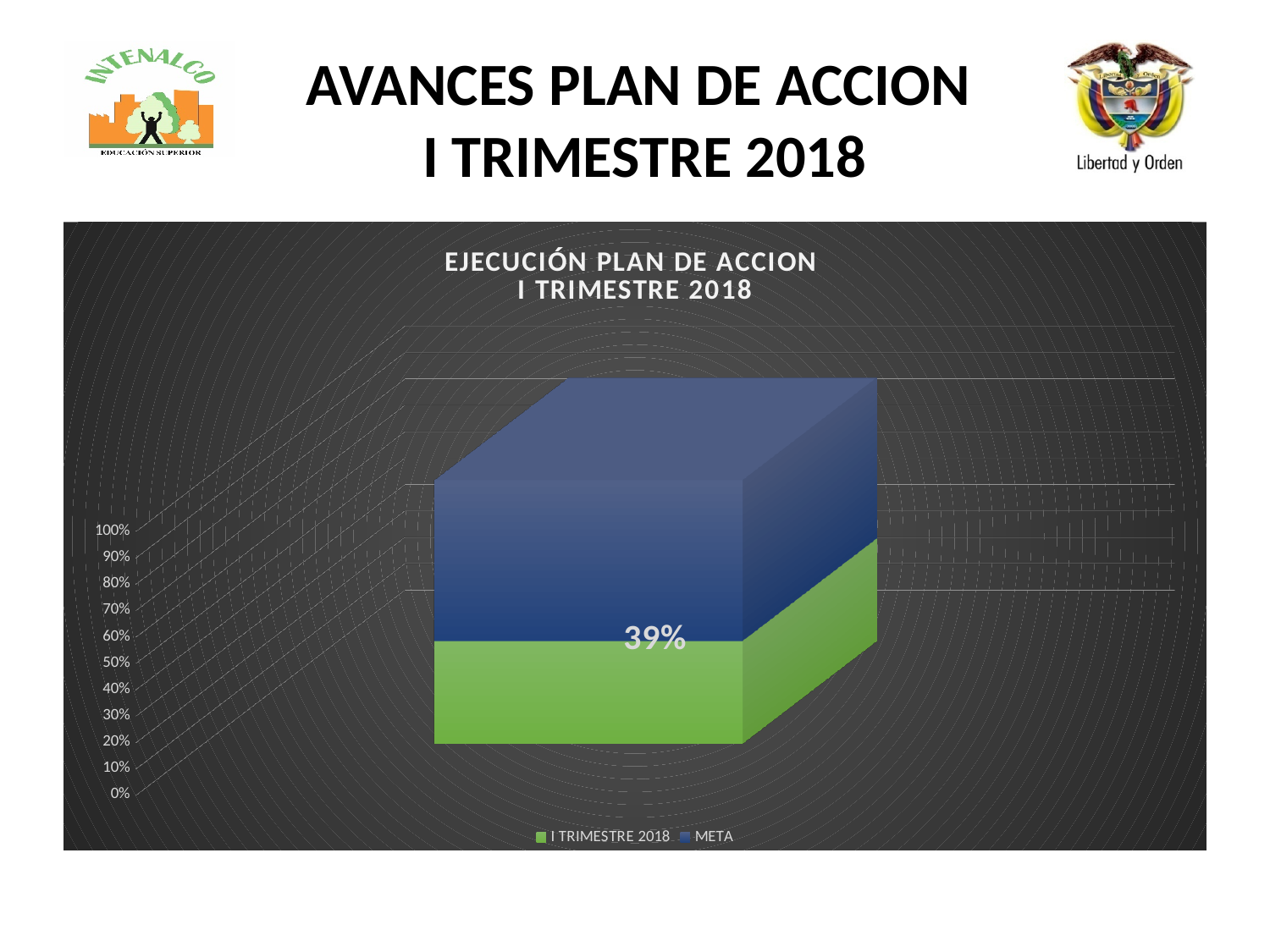
How many stacked bars are plotted in the chart? 1 Which series has the larger value, META or I TRIMESTRE 2018? META What is the title of the chart? EJECUCIÓN PLAN DE ACCION I TRIMESTRE 2018 What kind of chart is shown on the slide? Bar chart What is the highest percentage shown on the vertical axis? 100% Is the value for I TRIMESTRE 2018 greater or less than 50%? less Which series has the lowest value in the chart? I TRIMESTRE 2018 Is the value for META greater or less than 40%? greater How many series does the legend list? 2 What is the value shown for I TRIMESTRE 2018? 39% Which series has the highest value in the chart? META Which colour represents the I TRIMESTRE 2018 series? Green